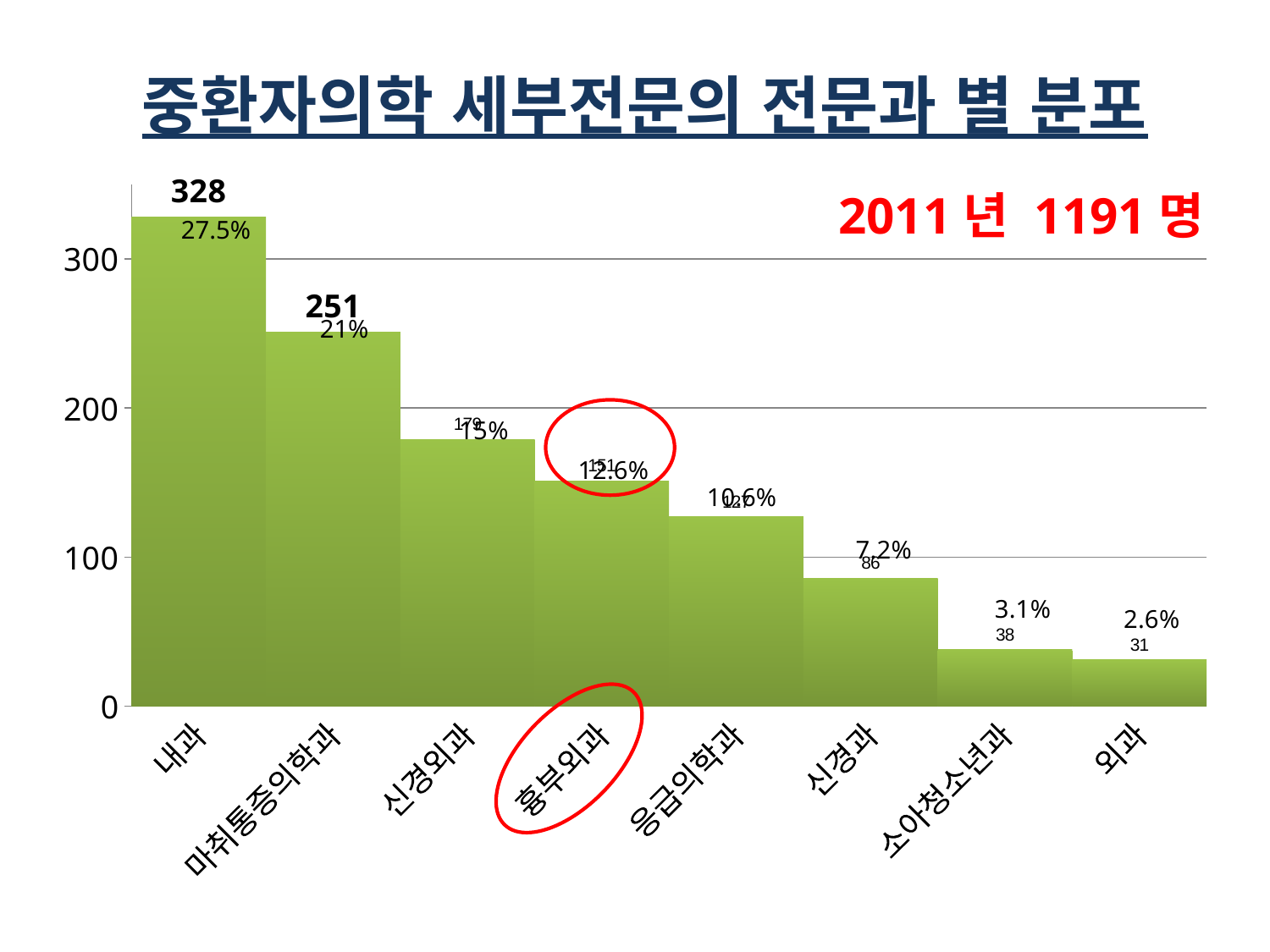
What is the value for 소아청소년과? 38 Which is larger, the value for 신경과 or the value for 소아청소년과? 신경과 What is the difference between the values for 내과 and 마취통증의학과? 77 Is the value for 신경외과 greater or less than 200? less What is the value for 마취통증의학과? 251 What is the value for 내과? 328 Which category has the highest value? 내과 What is the value for 신경과? 86 Which category has the lowest value? 외과 Do the values rise or fall from left to right along the x axis? fall How many categories are shown on the x axis? 8 What percentage is shown for 내과? 27.5%